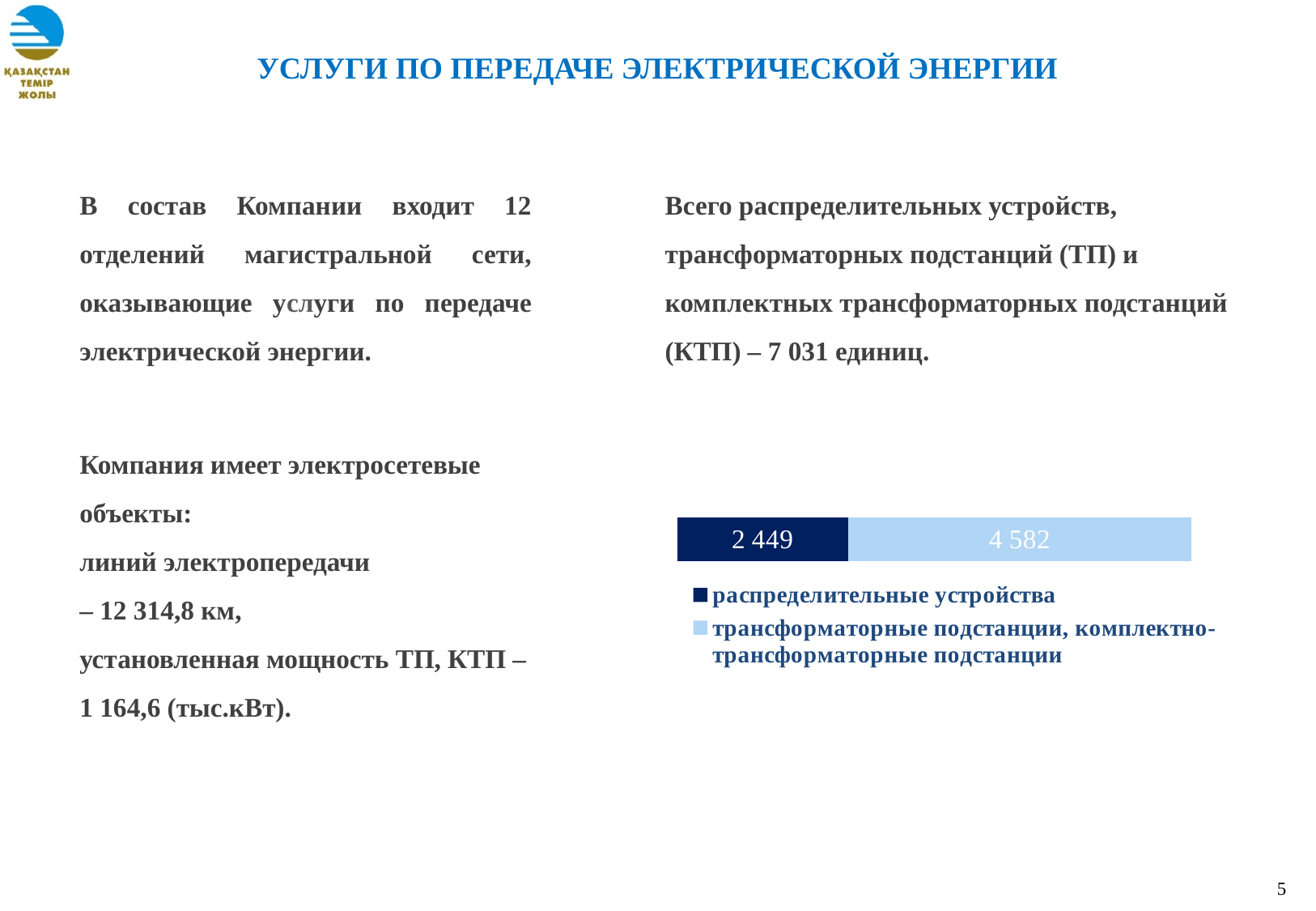
Is the value for распределительные устройства larger or smaller than the value for трансформаторные подстанции, комплектно-трансформаторные подстанции? smaller How many segments does the stacked bar in the chart have? 2 What kind of chart is shown on the slide? stacked bar chart What colour is the segment for распределительные устройства in the chart? dark blue Which series has the larger value in the chart? трансформаторные подстанции, комплектно-трансформаторные подстанции What is the value for трансформаторные подстанции, комплектно-трансформаторные подстанции in the chart? 4 582 What colour is the segment for трансформаторные подстанции, комплектно-трансформаторные подстанции in the chart? light blue What is the difference between the value for трансформаторные подстанции, комплектно-трансформаторные подстанции and the value for распределительные устройства? 2 133 What is the total of the stacked bar in the chart? 7 031 How many series does the legend of the chart list? 2 Which series has the smaller value in the chart? распределительные устройства What is the value for распределительные устройства in the chart? 2 449